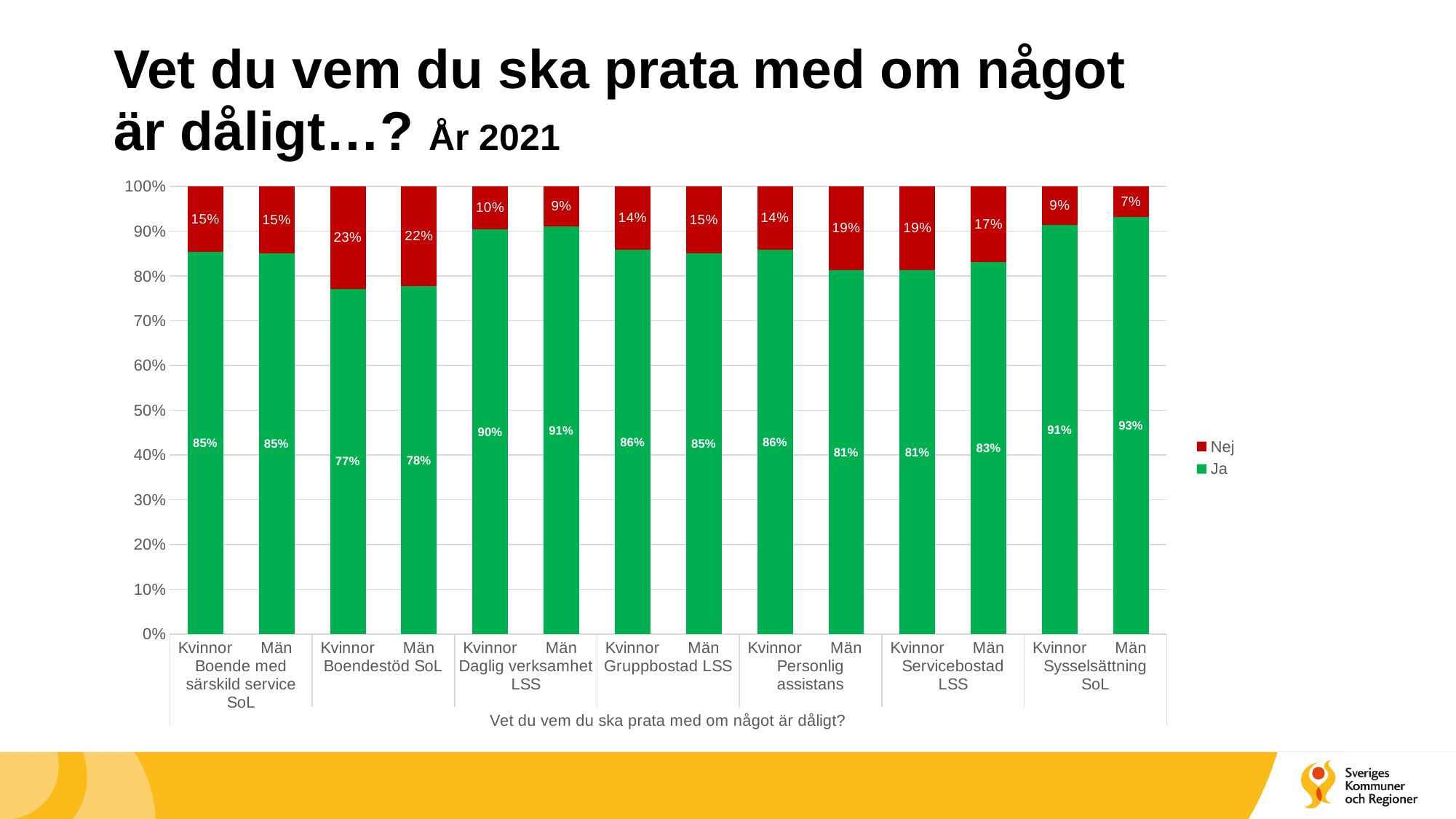
What is the Ja value for Män in Personlig assistans? 81% What is the Ja value for Kvinnor in Boendestöd SoL? 77% Which bar has the highest Ja value? Män, Sysselsättning SoL Which bar has the lowest Ja value? Kvinnor, Boendestöd SoL How many series does the legend list? 2 Which is larger, the Ja value for Kvinnor in Personlig assistans or the Ja value for Män in Personlig assistans? Kvinnor in Personlig assistans What is the total of the stacked bar for Män in Gruppbostad LSS? 100% How many bars are plotted in the chart? 14 What is the Nej value for Män in Sysselsättning SoL? 7% What is the difference between the Nej values for Kvinnor in Boendestöd SoL and Kvinnor in Daglig verksamhet LSS? 13 percentage points Which colour represents the Nej series in the legend? Red What kind of chart is shown on the slide? Stacked bar chart